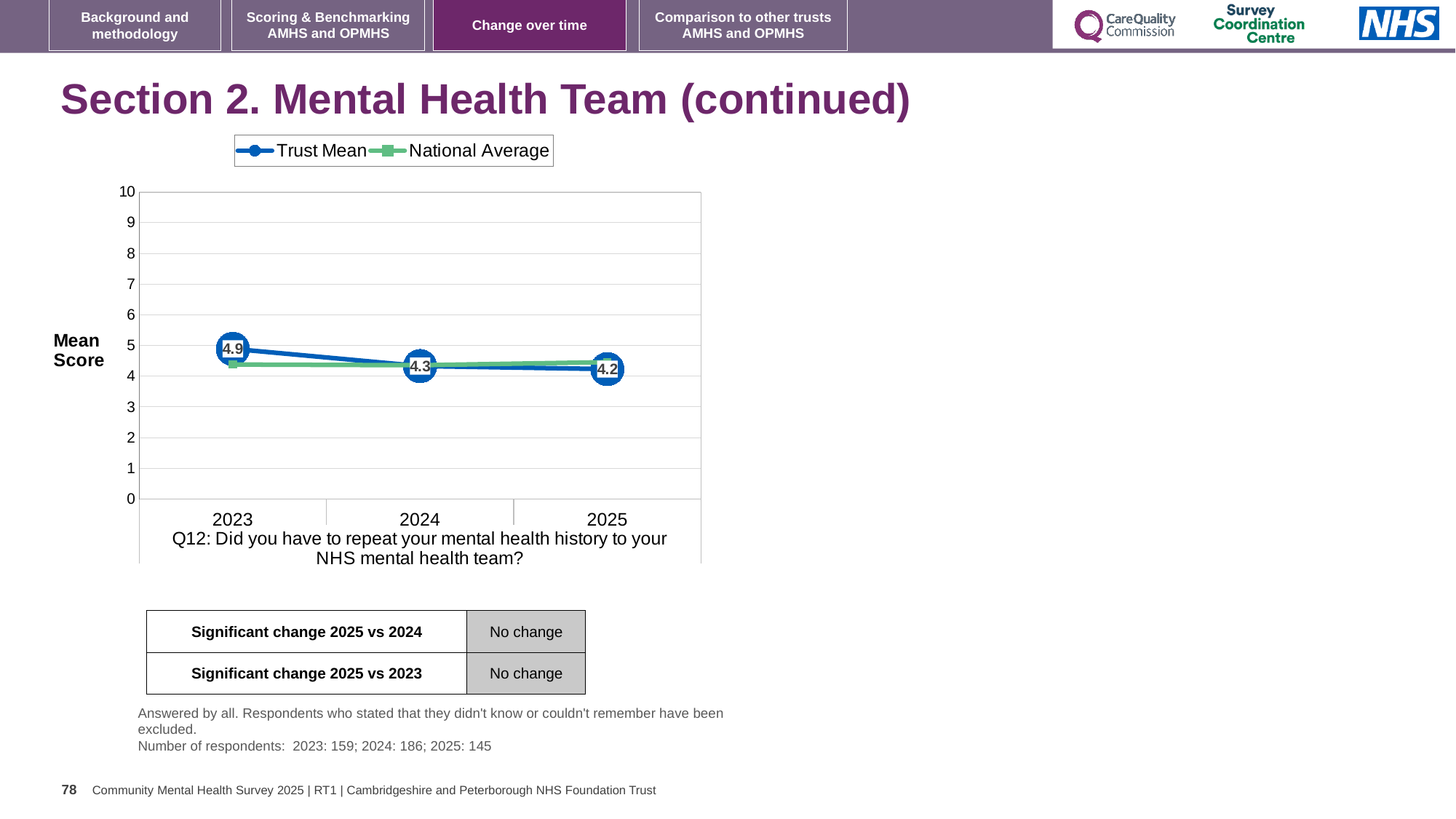
What is the difference between the Trust Mean scores for 2023 and 2025? 0.7 How many series does the chart legend list? 2 Which year has the larger Trust Mean score, 2023 or 2024? 2023 What is the Trust Mean score for 2023? 4.9 What is the Trust Mean score for 2025? 4.2 How many years are shown on the x axis of the chart? 3 In which year is the Trust Mean score lowest? 2025 In which year is the Trust Mean score highest? 2023 Does the Trust Mean score rise or fall from 2023 to 2025? Fall What kind of chart is shown on the slide? Line chart Is the National Average value for 2023 greater or less than 5? less What is the Trust Mean score for 2024? 4.3